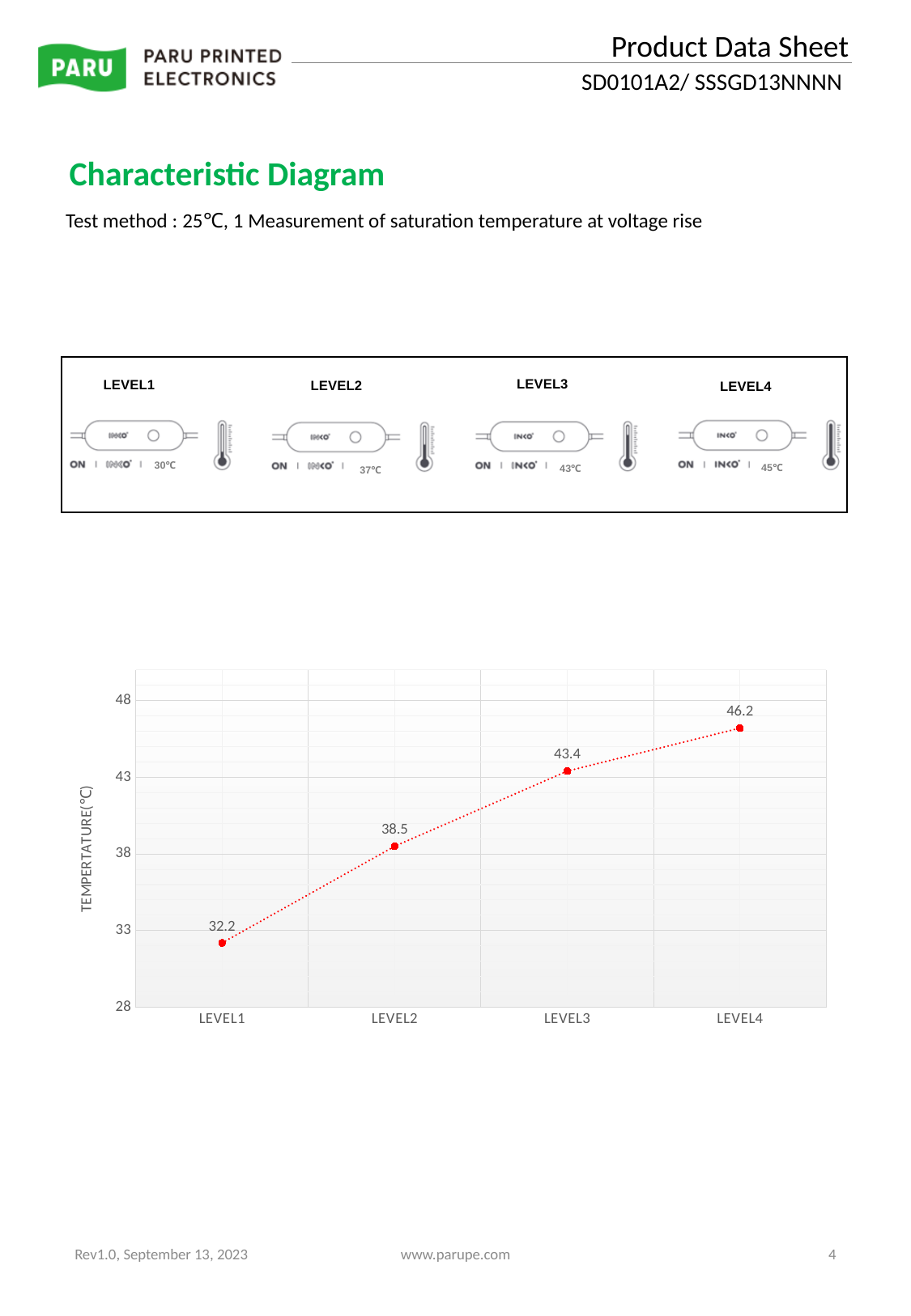
What is the difference between the temperature at LEVEL4 and at LEVEL1? 14 Does the temperature rise or fall from LEVEL1 to LEVEL4? rise Which level has the lowest temperature? LEVEL1 What is the temperature value for LEVEL1? 32.2 What is the difference between the temperature at LEVEL3 and at LEVEL2? 4.9 Which is larger, the temperature at LEVEL2 or at LEVEL3? LEVEL3 What is the temperature value for LEVEL2? 38.5 What kind of chart is shown? line chart Which level has the highest temperature? LEVEL4 What is the temperature value for LEVEL4? 46.2 How many levels are plotted on the chart? 4 What is the temperature value for LEVEL3? 43.4